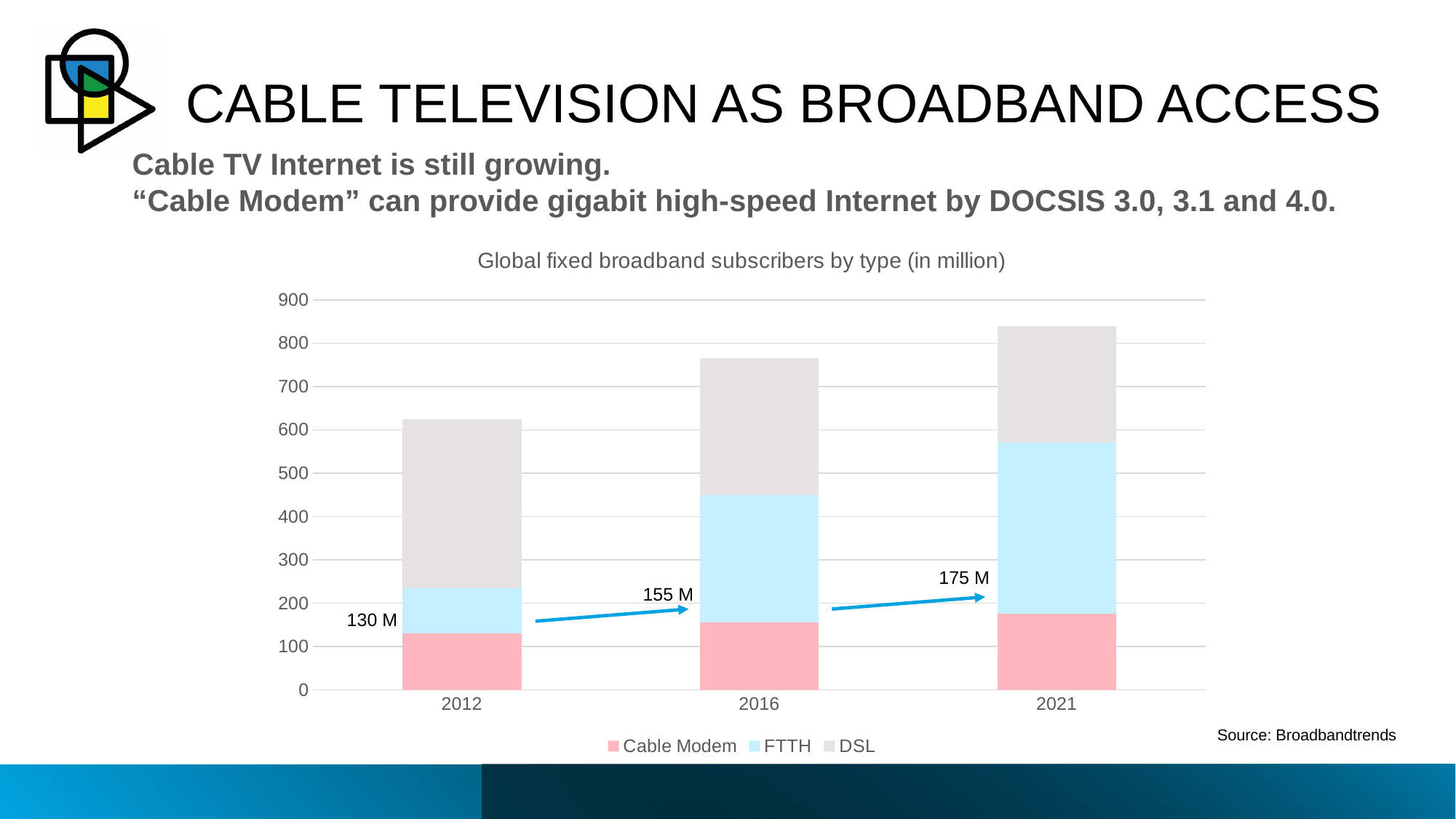
What is the Cable Modem value for 2016? 155 M Is the total height of the 2021 stacked bar greater or less than 800? greater How many years are shown on the x axis? 3 How many series does the legend list? 3 What is the difference between the Cable Modem values for 2021 and 2012? 45 M What is the Cable Modem value for 2021? 175 M In which year is the Cable Modem value highest? 2021 What is the Cable Modem value for 2012? 130 M Which is larger, the Cable Modem value for 2016 or for 2012? 2016 What kind of chart is shown on the slide? Stacked bar chart Is the total height of the 2012 stacked bar greater or less than 700? less In which year is the Cable Modem value lowest? 2012